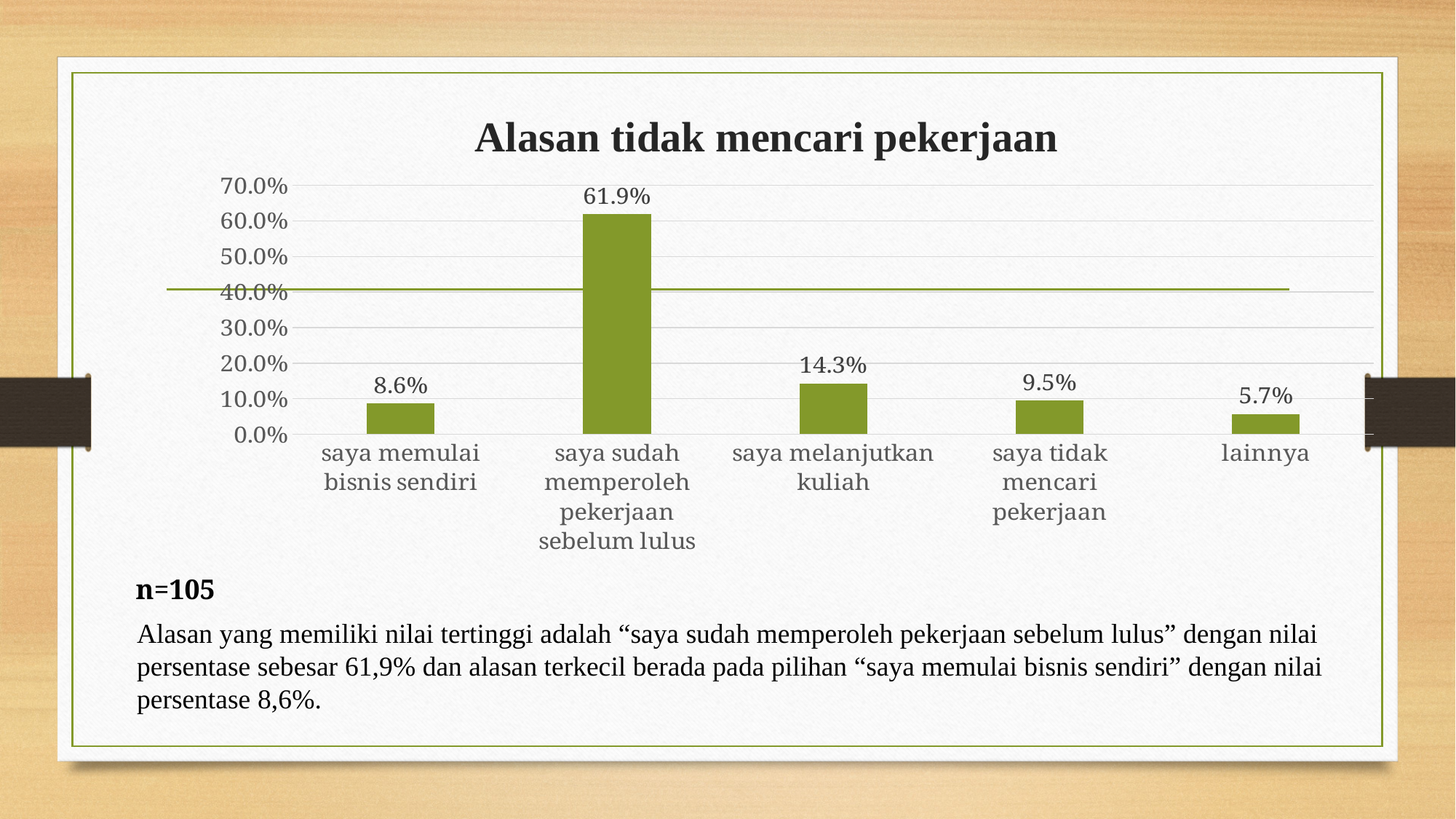
What is the value for "lainnya"? 5.7% What is the value for "saya melanjutkan kuliah"? 14.3% Which category has the highest value? saya sudah memperoleh pekerjaan sebelum lulus What is the value for "saya memulai bisnis sendiri"? 8.6% Which is larger, the value for "saya memulai bisnis sendiri" or the value for "saya tidak mencari pekerjaan"? saya tidak mencari pekerjaan How many categories are shown in the chart? 5 What is the difference between the values for "saya melanjutkan kuliah" and "saya tidak mencari pekerjaan"? 4.8% Which category has the lowest value? lainnya What is the value for "saya sudah memperoleh pekerjaan sebelum lulus"? 61.9% Is the value for "saya sudah memperoleh pekerjaan sebelum lulus" greater or less than 50.0%? greater What is the title of the chart? Alasan tidak mencari pekerjaan What kind of chart is shown on the slide? bar chart